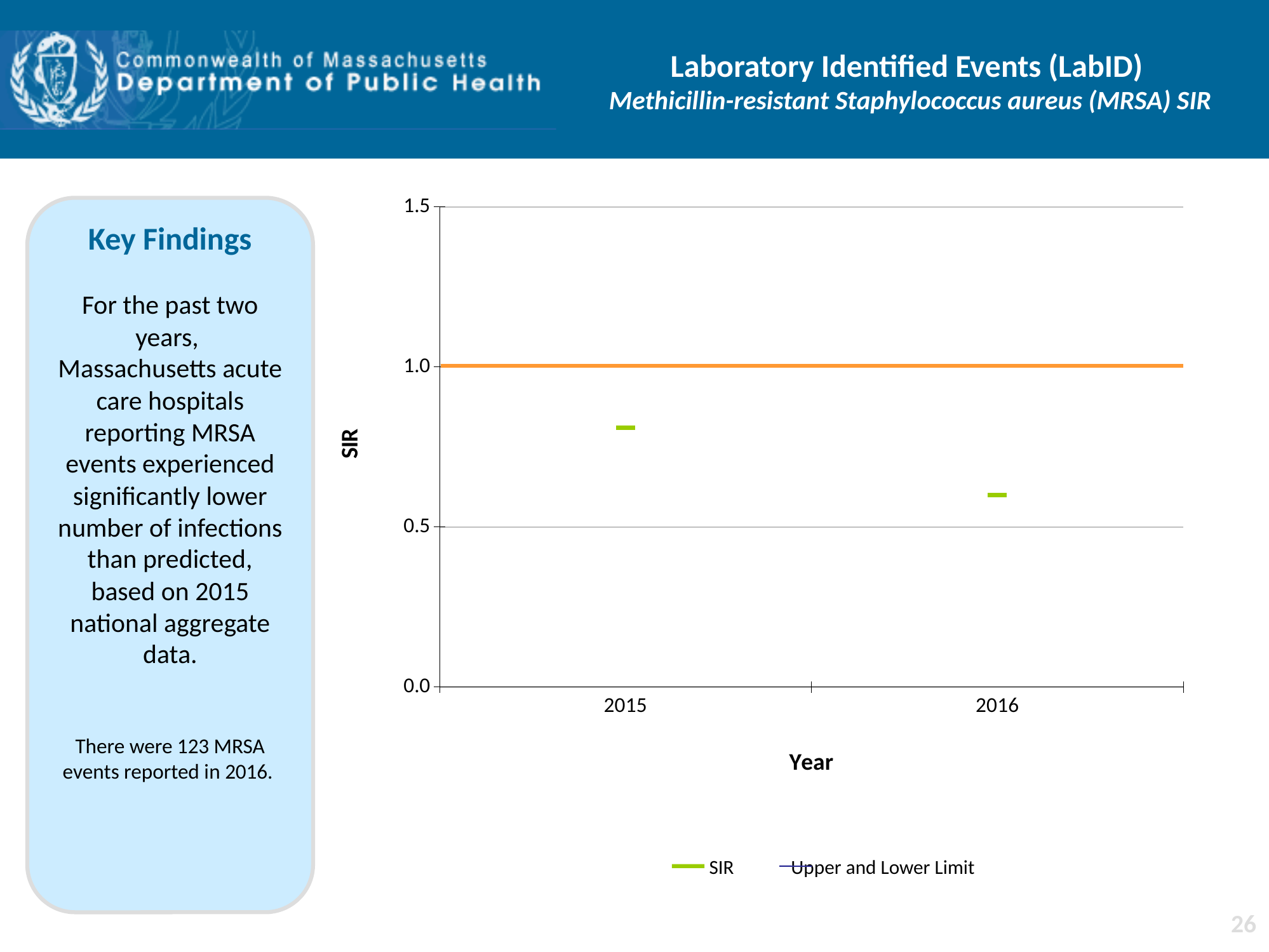
How many years are shown on the x axis of the chart? 2 Which year has the lowest SIR value? 2016 What are the two entries listed in the chart legend? SIR; Upper and Lower Limit Which year has the highest SIR value? 2015 What is the title of the y axis of the chart? SIR What is the highest value shown on the y axis of the chart? 1.5 Is the SIR value for 2016 greater or less than 0.5? greater How many series does the chart legend list? 2 Is the SIR value for 2015 greater or less than 1.0? less Does the SIR value rise or fall from 2015 to 2016? fall Which year has the higher SIR value, 2015 or 2016? 2015 Is the SIR value for 2015 greater or less than 0.5? greater